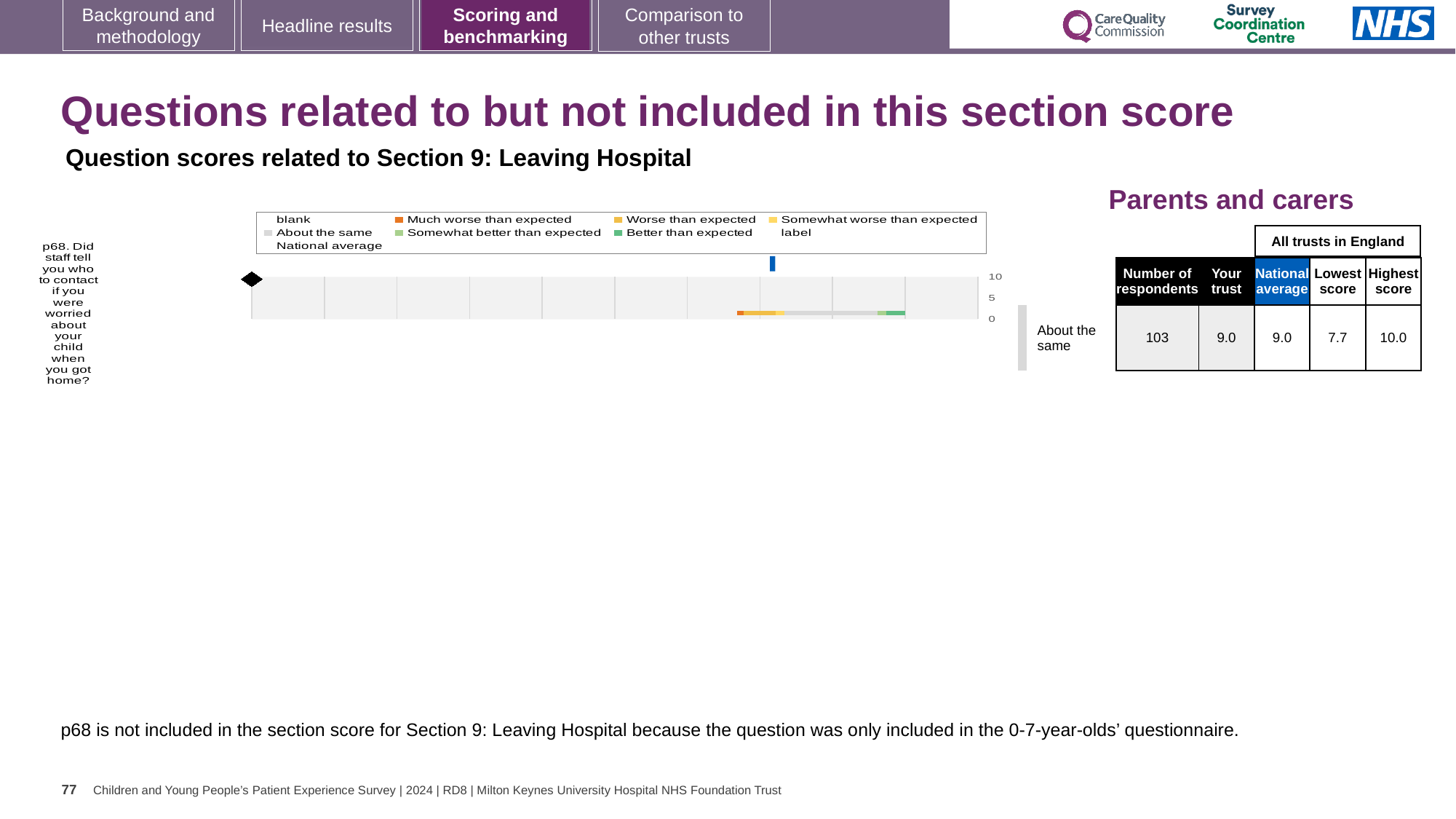
What is the difference between the highest score and the lowest score for question p68? 2.3 How many questions (categories) are plotted in the chart? 1 How many entries does the chart legend list? 9 What is the highest score among all trusts in England for question p68? 10.0 Which legend entry is shown in orange? Much worse than expected What kind of chart is shown for question p68? bar chart What is the highest value shown on the chart's axis? 10 What is the lowest score among all trusts in England for question p68? 7.7 What is the 'Your trust' score for question p68? 9.0 How many respondents answered question p68? 103 What is the national average score for question p68? 9.0 What benchmark category label is shown next to the chart for question p68? About the same